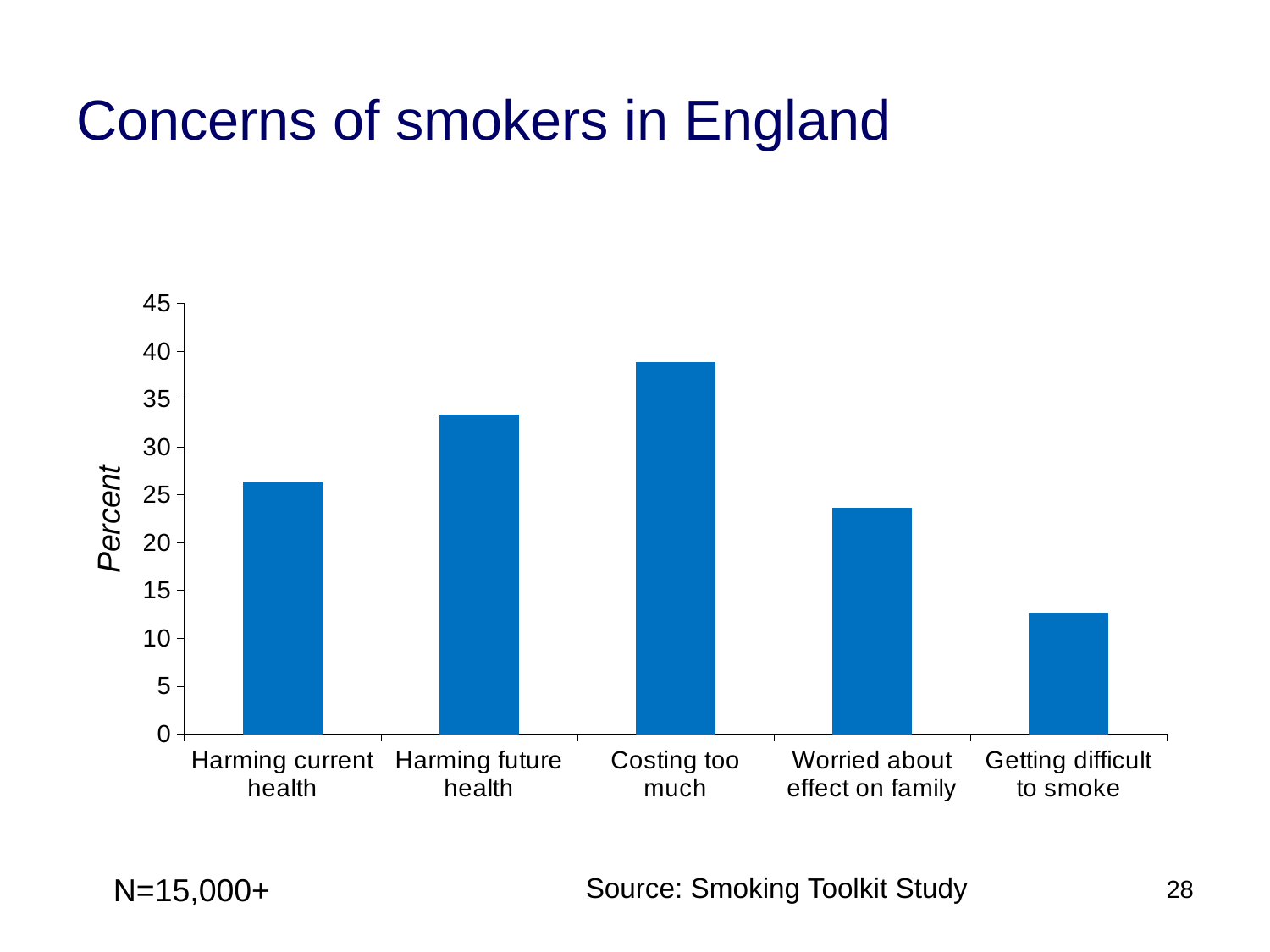
Which is larger, the value for Harming future health or the value for Harming current health? Harming future health What is the label on the y axis of the chart? Percent How many categories are shown on the x axis of the chart? 5 What kind of chart is shown on the slide? bar chart Which concern has the highest percentage? Costing too much Is the value for Costing too much greater or less than 35? greater Which concern has the lowest percentage? Getting difficult to smoke Is the value for Harming current health greater or less than 20? greater Is the value for Getting difficult to smoke greater or less than 15? less Which is larger, the value for Harming current health or the value for Worried about effect on family? Harming current health